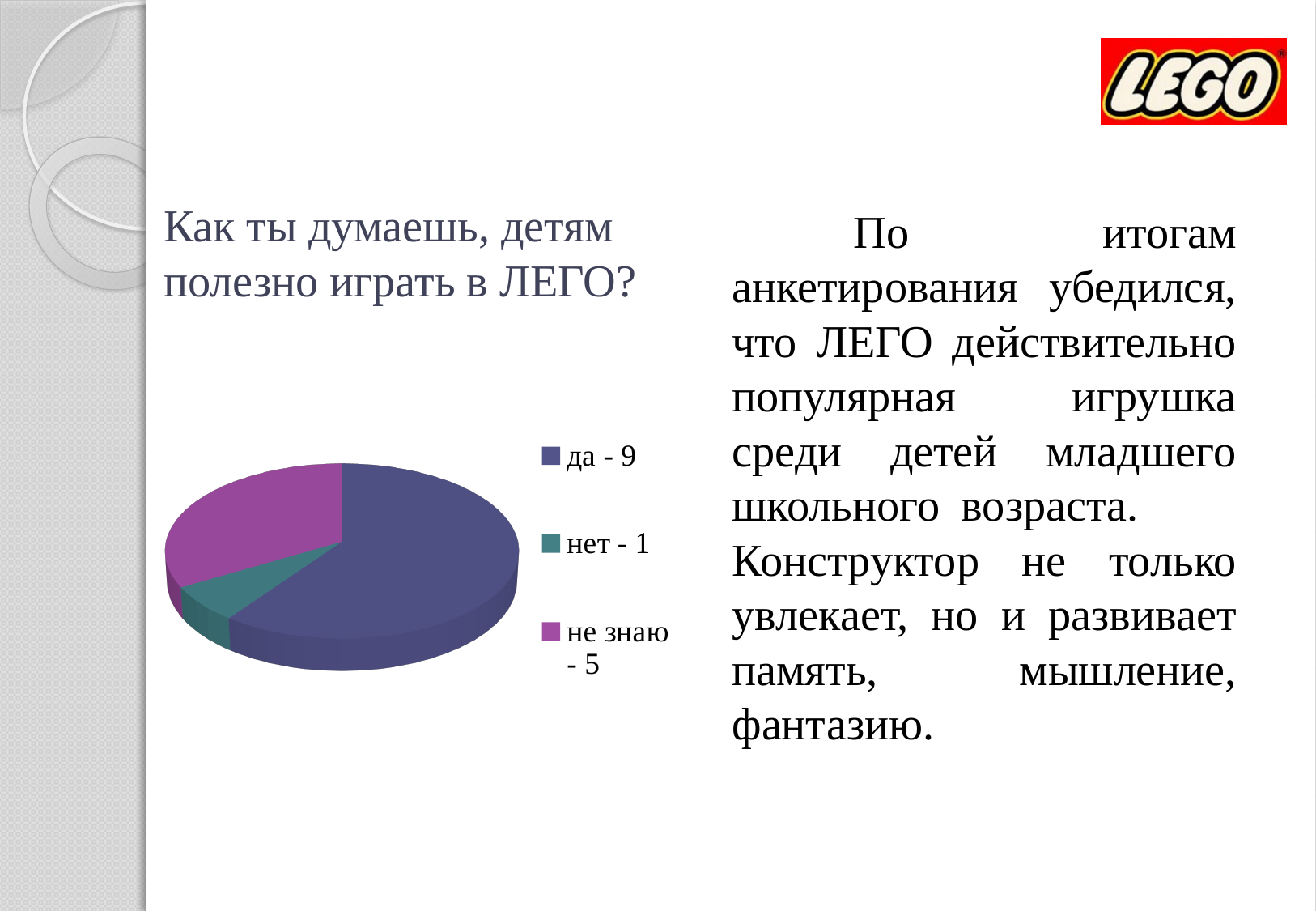
Which answer has the largest slice of the pie? да What share of all responses does the "да" slice represent? 60% Which is larger: the number of "не знаю" answers or the number of "нет" answers? не знаю How many categories does the pie chart have? 3 How many respondents answered "не знаю" according to the legend? 5 What is the total number of responses shown in the pie chart? 15 What is the difference between the number of "да" answers and "не знаю" answers? 4 How many respondents answered "да" according to the legend? 9 How many respondents answered "нет" according to the legend? 1 What question is the pie chart about, according to the heading above it? Как ты думаешь, детям полезно играть в ЛЕГО? Which answer has the smallest slice of the pie? нет What kind of chart is shown on the slide? pie chart